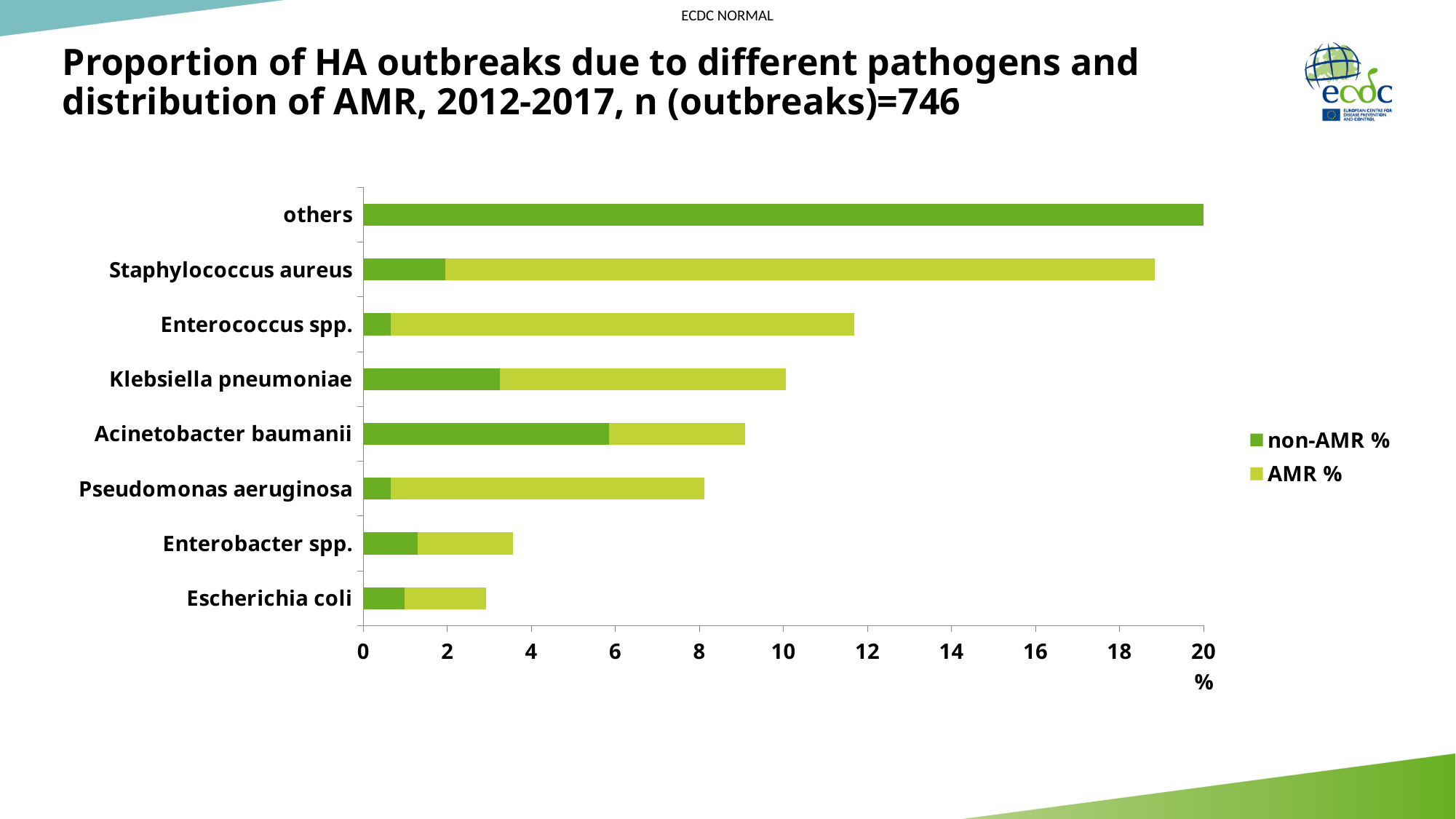
Is the total value for Enterococcus spp. greater or less than 10? greater Which has a larger non-AMR % segment, Acinetobacter baumanii or Klebsiella pneumoniae? Acinetobacter baumanii How many pathogen categories are shown on the chart? 8 Which category has the shortest total bar? Escherichia coli What are the two series named in the legend? non-AMR % and AMR % How many series does the legend list? 2 Is the total value for Staphylococcus aureus greater or less than 18? greater Is the total value for Acinetobacter baumanii greater or less than 10? less Which has a larger total bar, Staphylococcus aureus or Enterococcus spp.? Staphylococcus aureus What kind of chart is shown on the slide? Stacked bar chart Which category has the longest total bar? others